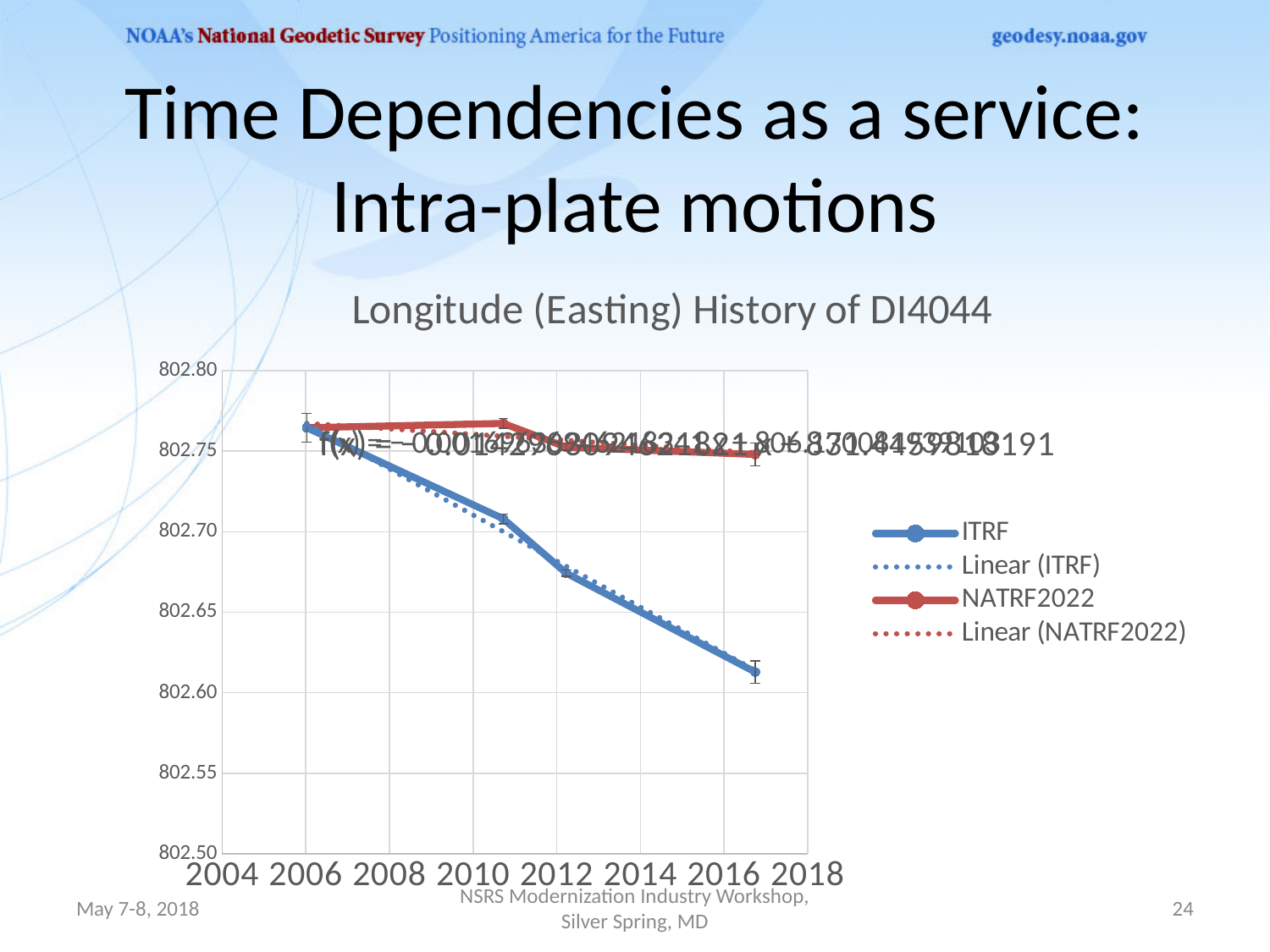
Is the ITRF value at the first point (around 2006) greater or less than 802.75? greater Which series has the lowest plotted value on the chart? ITRF Which two data series (excluding trendlines) are plotted in the chart? ITRF and NATRF2022 How many data points are plotted for the ITRF series? 4 How many entries does the chart legend list? 4 What kind of chart is shown on the slide? Line chart Is the NATRF2022 value at the last point (around 2017) greater or less than 802.70? greater What is the title of the chart? Longitude (Easting) History of DI4044 Is the ITRF value at the last point (around 2017) greater or less than 802.65? less At the last point (around 2017), which series has the higher value, ITRF or NATRF2022? NATRF2022 Does the ITRF series rise or fall over time from 2006 to 2017? Fall